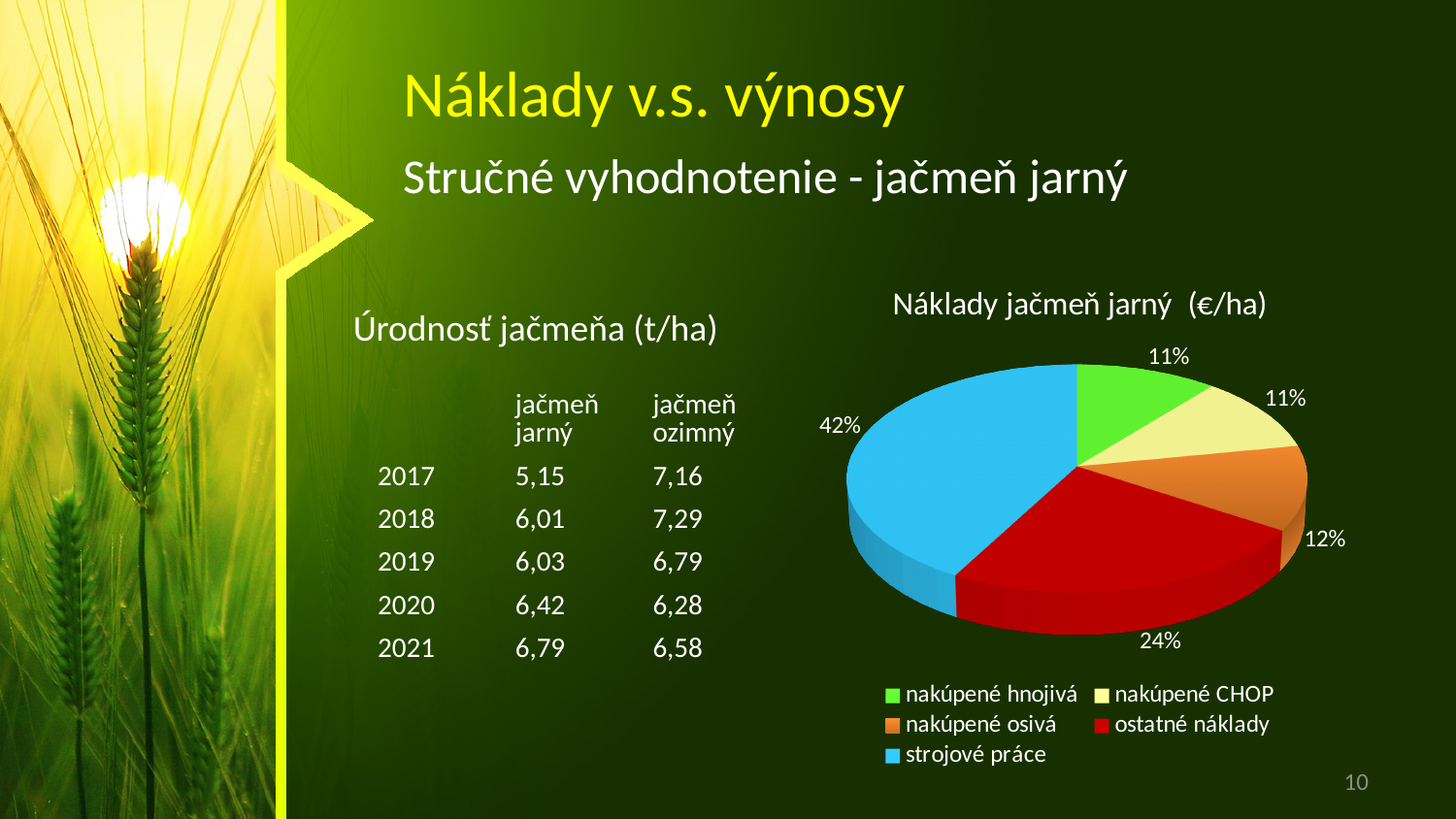
Which category has the largest slice of the pie? strojové práce What share of the pie does nakúpené hnojivá have? 11% What is the difference in percentage points between strojové práce and ostatné náklady? 18 What share of the pie does ostatné náklady have? 24% How many entries does the legend of the pie chart list? 5 What share of the pie does nakúpené CHOP have? 11% What kind of chart is shown on the slide? pie chart What is the title of the pie chart? Náklady jačmeň jarný (€/ha) Which is larger, the share for ostatné náklady or the share for nakúpené osivá? ostatné náklady How many slices does the pie chart have? 5